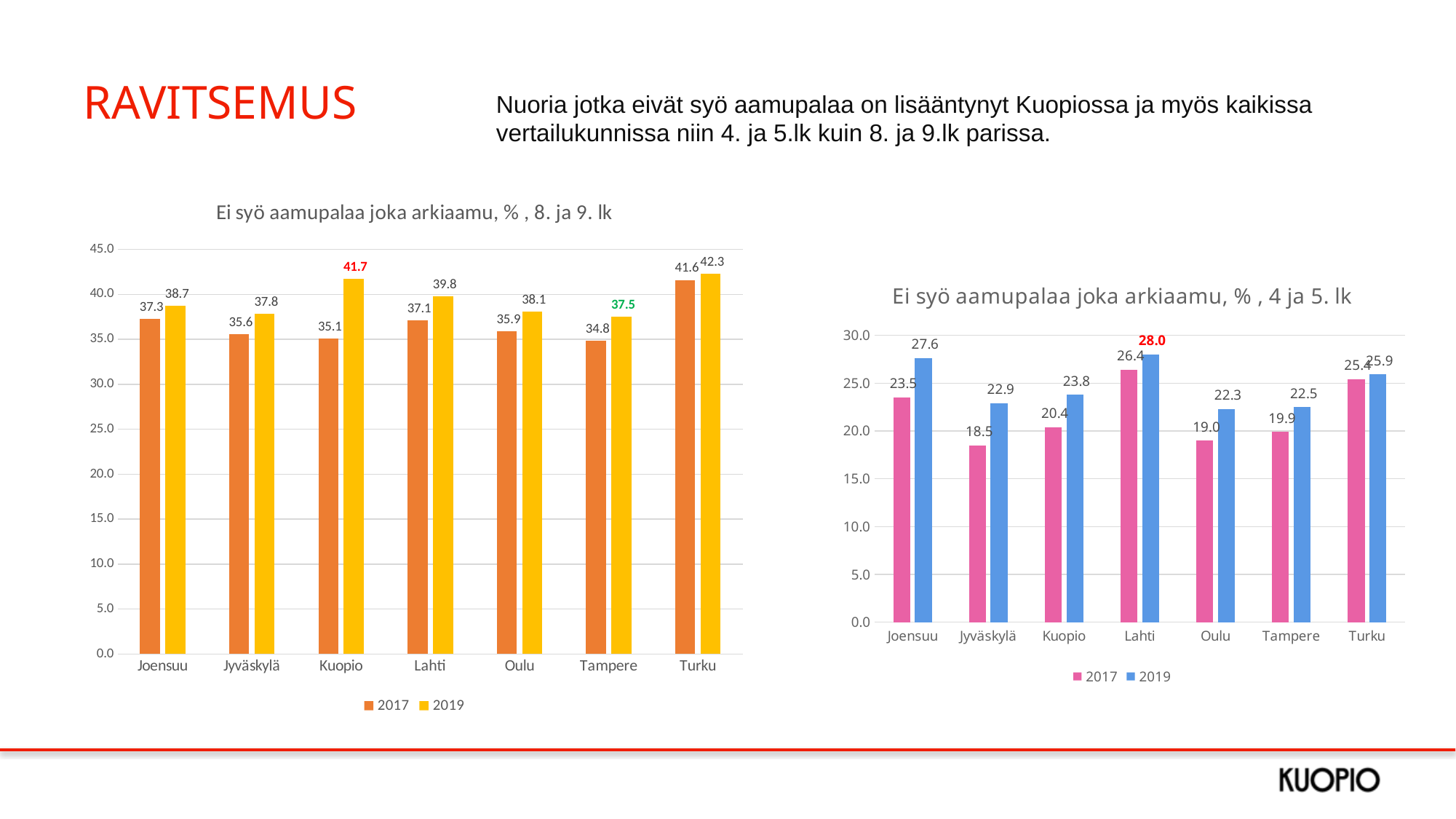
In the chart titled 'Ei syö aamupalaa joka arkiaamu, % , 8. ja 9. lk', what is the 2017 value for Tampere? 34.8 In the chart titled 'Ei syö aamupalaa joka arkiaamu, % , 4 ja 5. lk', which is larger: the 2017 value for Joensuu or the 2017 value for Kuopio? Joensuu In the chart titled 'Ei syö aamupalaa joka arkiaamu, % , 4 ja 5. lk', what is the 2019 value for Lahti? 28.0 In the chart titled 'Ei syö aamupalaa joka arkiaamu, % , 8. ja 9. lk', which city has the highest 2019 value? Turku In the chart titled 'Ei syö aamupalaa joka arkiaamu, % , 4 ja 5. lk', what is the 2017 value for Jyväskylä? 18.5 What kind of chart is the chart titled 'Ei syö aamupalaa joka arkiaamu, % , 4 ja 5. lk'? Bar chart In the chart titled 'Ei syö aamupalaa joka arkiaamu, % , 8. ja 9. lk', what is the 2019 value for Kuopio? 41.7 In the chart titled 'Ei syö aamupalaa joka arkiaamu, % , 8. ja 9. lk', which city has the lowest 2017 value? Tampere In the chart titled 'Ei syö aamupalaa joka arkiaamu, % , 8. ja 9. lk', what is the difference between the 2019 and 2017 values for Kuopio? 6.6 In the chart titled 'Ei syö aamupalaa joka arkiaamu, % , 8. ja 9. lk', how many cities are shown on the x axis? 7 In the chart titled 'Ei syö aamupalaa joka arkiaamu, % , 4 ja 5. lk', how many series does the legend list? 2 In the chart titled 'Ei syö aamupalaa joka arkiaamu, % , 4 ja 5. lk', which city has the lowest 2019 value? Oulu